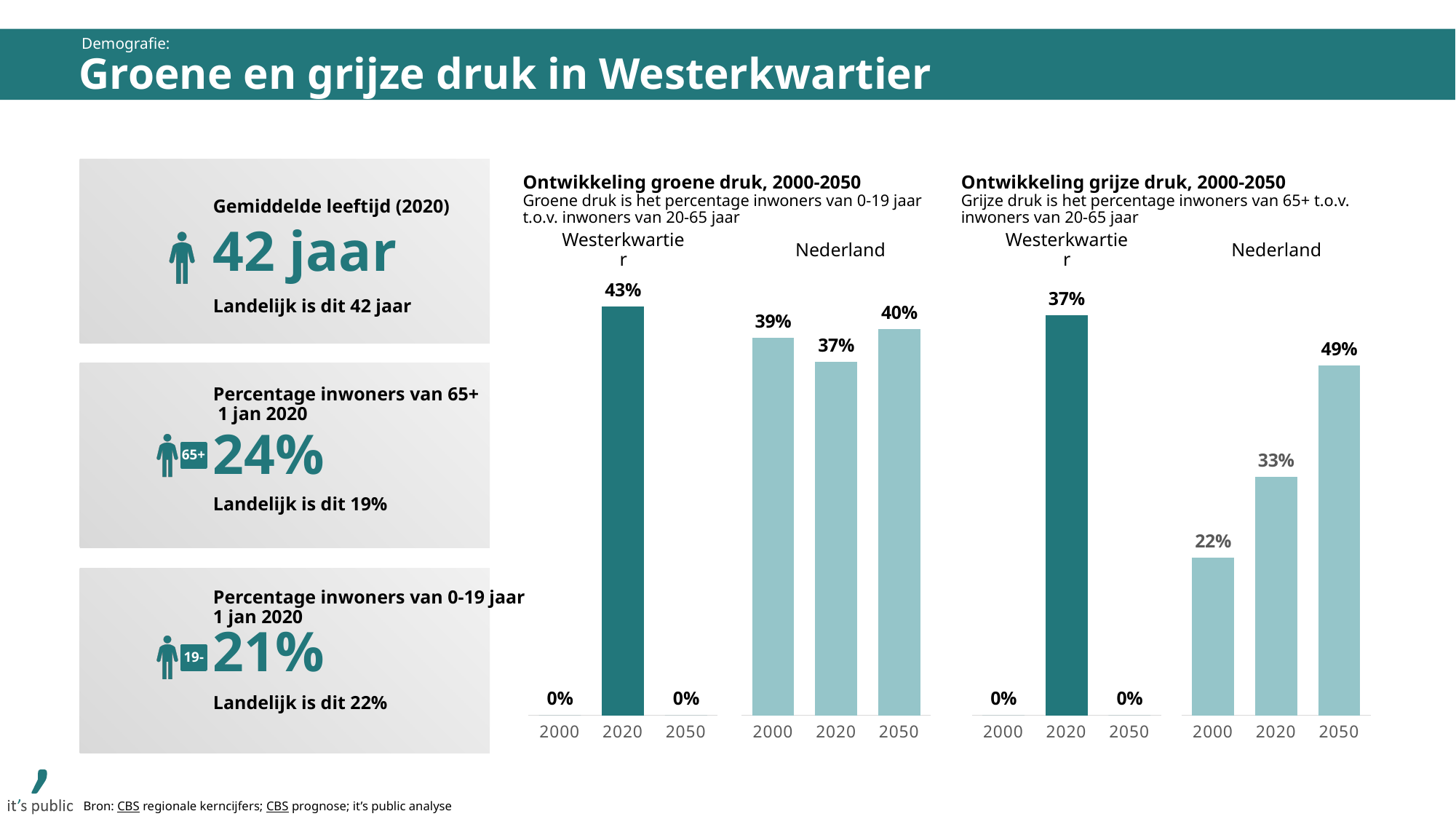
In the 'Ontwikkeling groene druk, 2000-2050' chart, what is the value for Nederland in 2050? 40% In the 'Ontwikkeling grijze druk, 2000-2050' chart, what is the difference between the Nederland values for 2050 and 2000? 27% In the 'Ontwikkeling groene druk, 2000-2050' chart, what is the value for Westerkwartier in 2020? 43% In the 'Ontwikkeling groene druk, 2000-2050' chart, which year has the lowest value for Nederland? 2020 How many years are shown on the x axis for Nederland in the 'Ontwikkeling grijze druk, 2000-2050' chart? 3 In the 'Ontwikkeling grijze druk, 2000-2050' chart, which year has the highest value for Nederland? 2050 What type of chart is 'Ontwikkeling groene druk, 2000-2050'? bar chart In the 'Ontwikkeling grijze druk, 2000-2050' chart, which is larger: the Westerkwartier 2020 value or the Nederland 2020 value? Westerkwartier 2020 In the 'Ontwikkeling grijze druk, 2000-2050' chart, what is the value for Westerkwartier in 2020? 37% In the 'Ontwikkeling groene druk, 2000-2050' chart, what is the difference between the Westerkwartier 2020 value and the Nederland 2020 value? 6% In the 'Ontwikkeling grijze druk, 2000-2050' chart, do the Nederland values rise or fall from 2000 to 2050? rise In the 'Ontwikkeling grijze druk, 2000-2050' chart, what is the value for Nederland in 2000? 22%